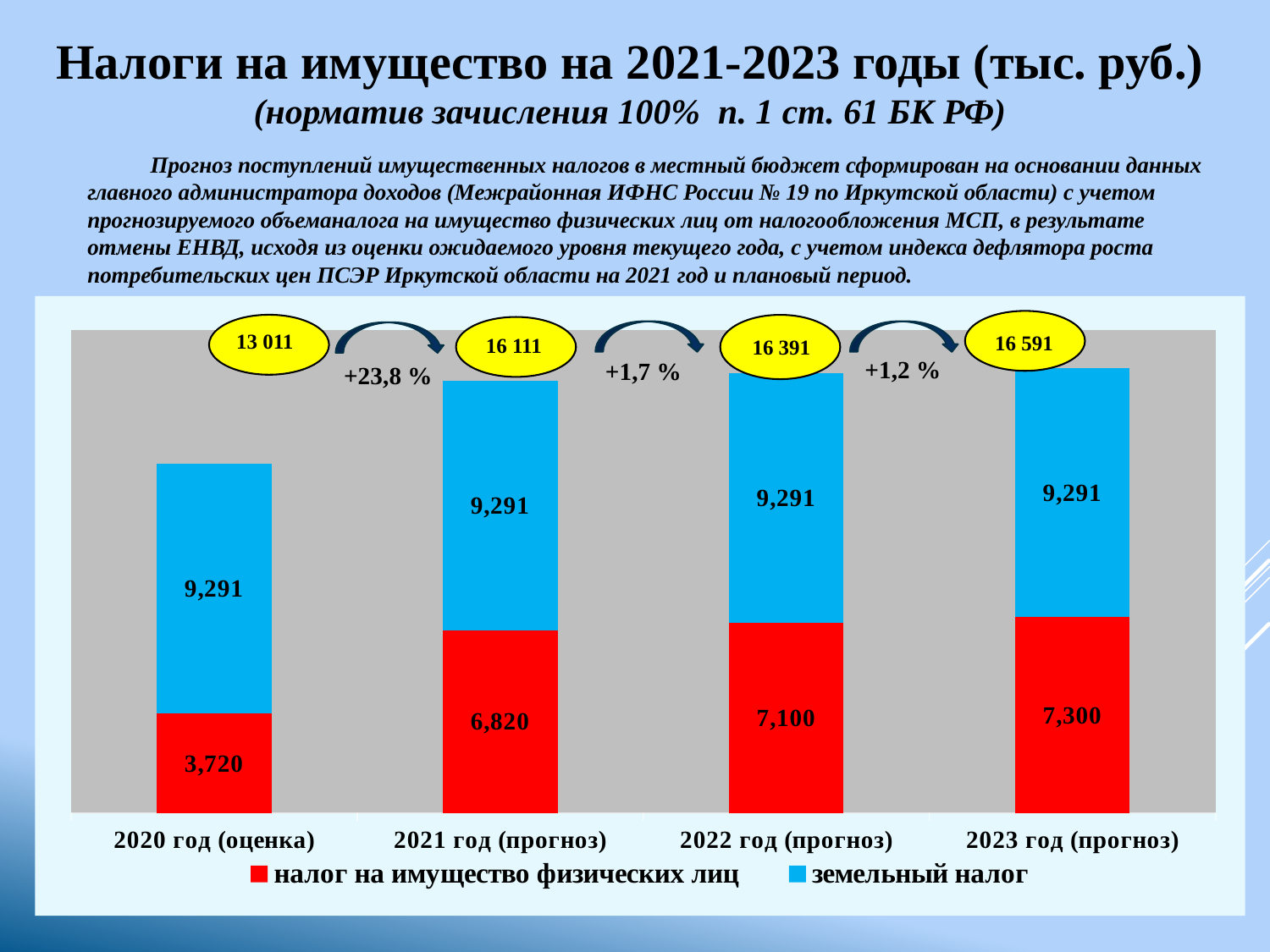
What is the value of налог на имущество физических лиц for 2023 год (прогноз)? 7,300 Which year has the lowest value for налог на имущество физических лиц? 2020 год (оценка) How many series does the legend list? 2 How many year categories are shown on the x axis? 4 What is the total shown above the bar for 2023 год (прогноз)? 16 591 What is the value of земельный налог for 2022 год (прогноз)? 9,291 What kind of chart is shown on the slide? stacked bar chart Which is larger for 2021 год (прогноз): налог на имущество физических лиц or земельный налог? земельный налог What is the total shown above the bar for 2021 год (прогноз)? 16 111 What is the value of налог на имущество физических лиц for 2020 год (оценка)? 3,720 Which year has the highest total shown above its bar? 2023 год (прогноз) What is the difference between налог на имущество физических лиц in 2021 год (прогноз) and 2020 год (оценка)? 3,100